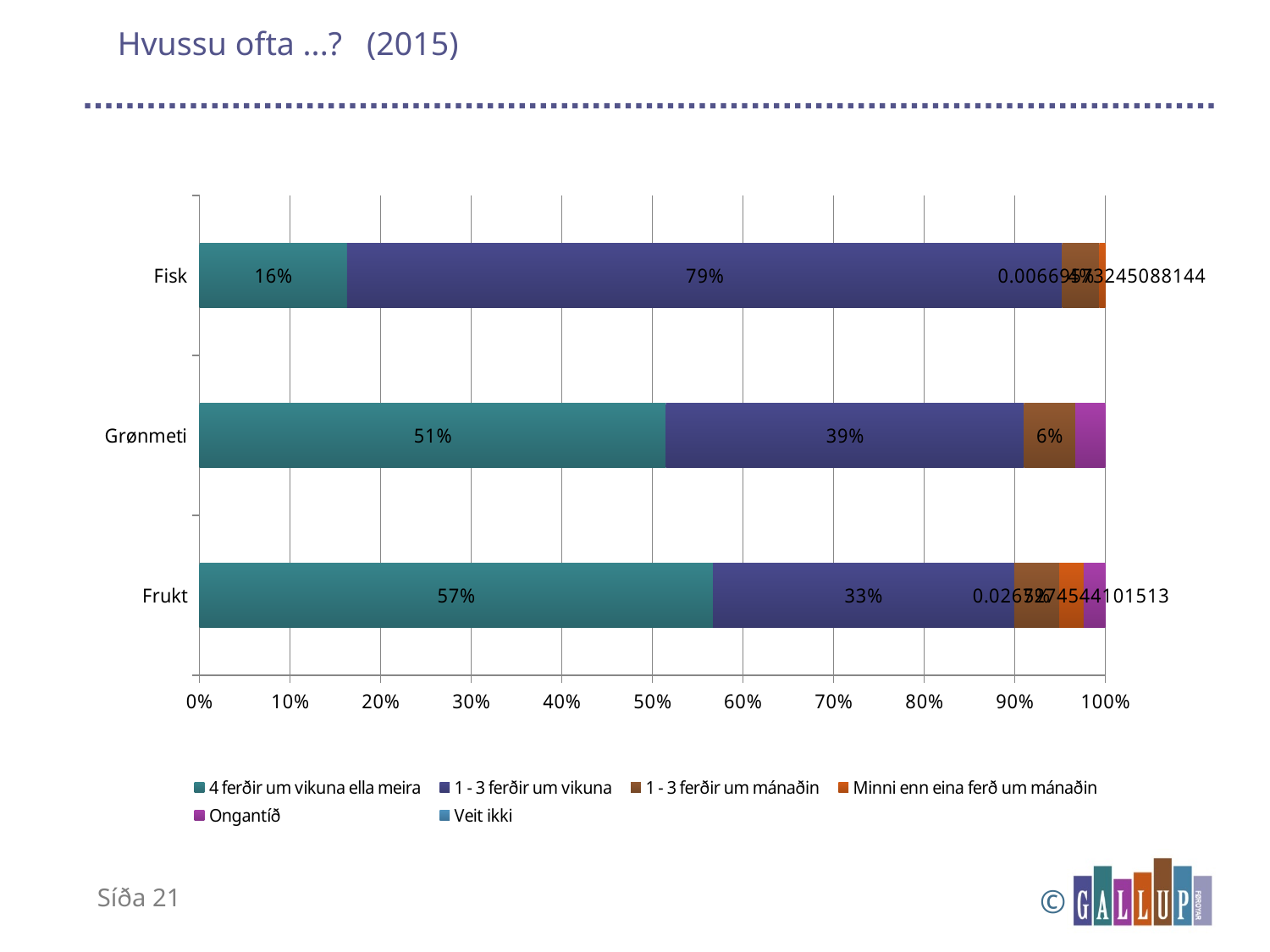
What is the value of '1 - 3 ferðir um vikuna' for Frukt? 33% How many categories are shown on the vertical axis of the chart? 3 What is the value of '1 - 3 ferðir um mánaðin' for Grønmeti? 6% What is the value of '4 ferðir um vikuna ella meira' for Grønmeti? 51% What is the value of '1 - 3 ferðir um vikuna' for Fisk? 79% What is the difference between the '4 ferðir um vikuna ella meira' values for Frukt and Grønmeti? 6% What is the value of '4 ferðir um vikuna ella meira' for Fisk? 16% Which category has the lowest value for '1 - 3 ferðir um vikuna'? Frukt Which category has the highest value for '4 ferðir um vikuna ella meira'? Frukt How many series does the legend list? 6 Is the '1 - 3 ferðir um vikuna' value for Fisk greater or less than 70%? greater What kind of chart is shown on the slide? stacked bar chart